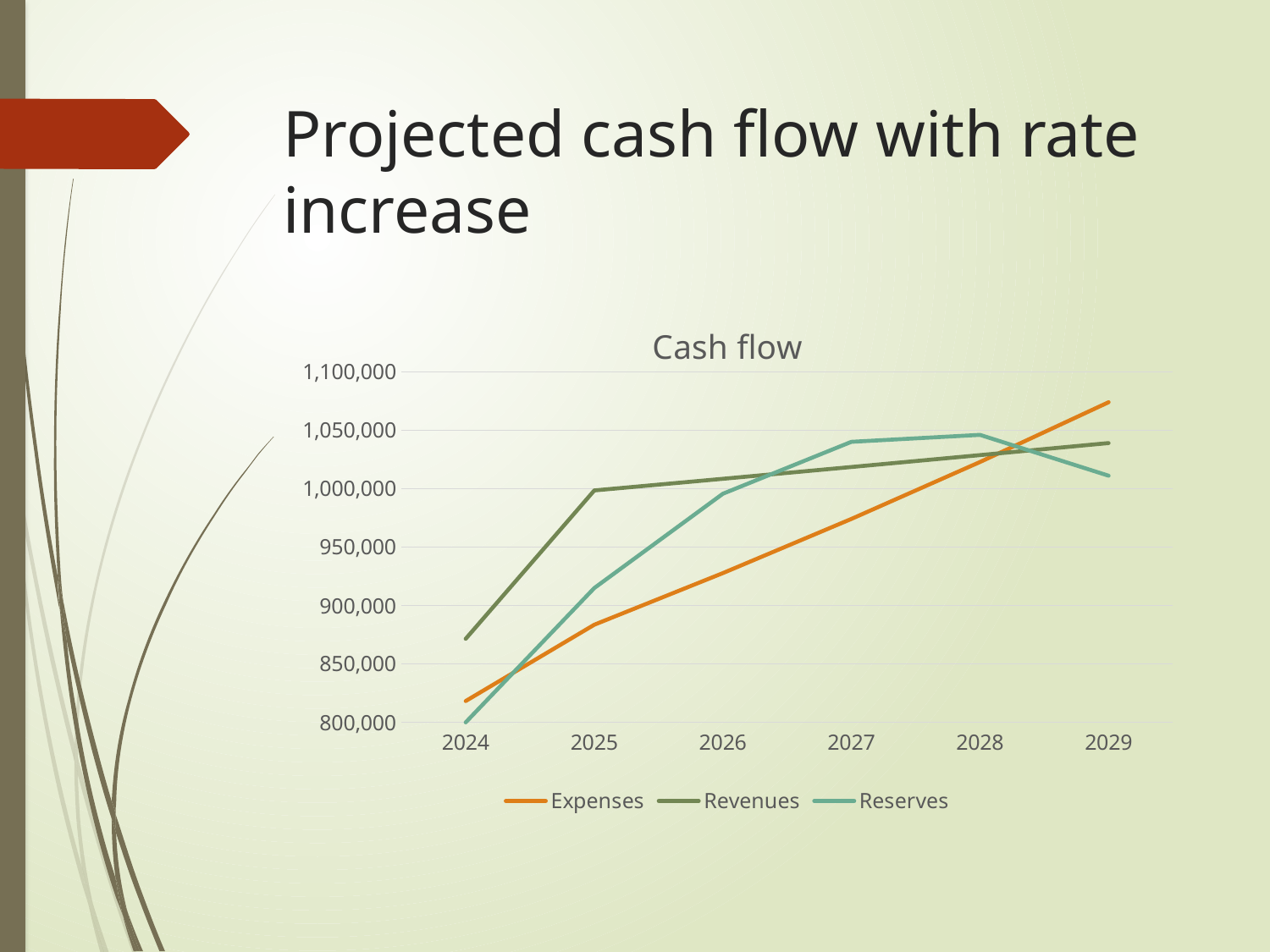
How many series does the legend list? 3 In 2029, which is higher, Expenses or Revenues? Expenses Do Expenses rise or fall from 2024 to 2029? rise Is the value for Revenues in 2024 greater or less than 900,000? less Is the value for Expenses in 2026 greater or less than 950,000? less In 2025, which is higher, Revenues or Expenses? Revenues Is the value for Expenses in 2029 greater or less than 1,050,000? greater What kind of chart is shown on the slide? line chart What is the title of the chart? Cash flow How many years are shown on the x axis? 6 Which series are listed in the legend? Expenses, Revenues, Reserves